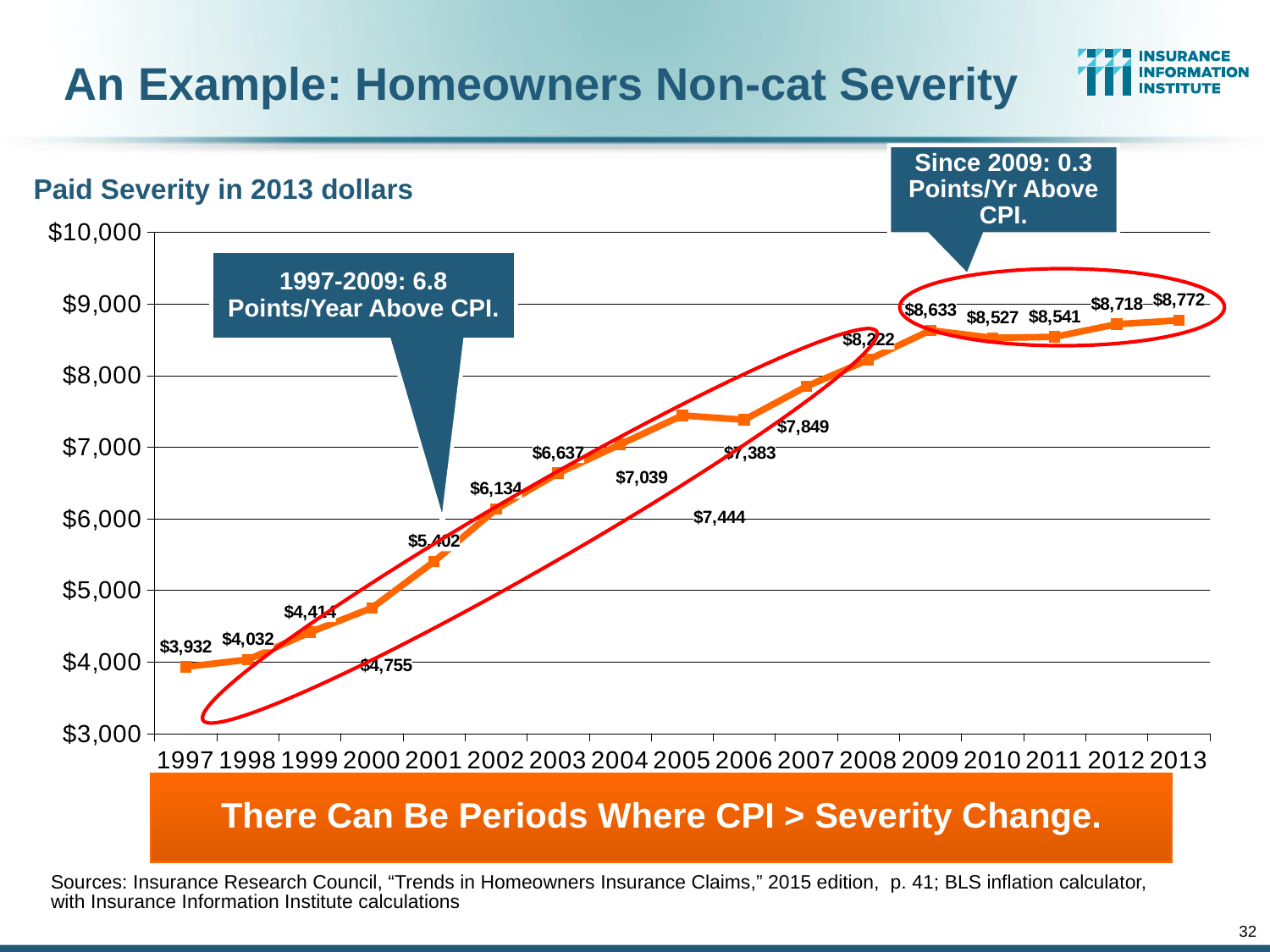
What is the paid severity value for 2009? $8,633 Does paid severity generally rise or fall from 1997 to 2013? rise Which year has the highest paid severity? 2013 What is the difference between the paid severity in 2013 and in 1997? $4,840 How many years are plotted on the x axis? 17 Is the value for 2001 greater or less than $5,000? greater What is the paid severity value for 2008? $8,222 What is the paid severity value for 1997? $3,932 Which year has the larger paid severity, 2009 or 2010? 2009 Which year has the lowest paid severity? 1997 What kind of chart is shown on the slide? line chart What is the paid severity value for 2013? $8,772